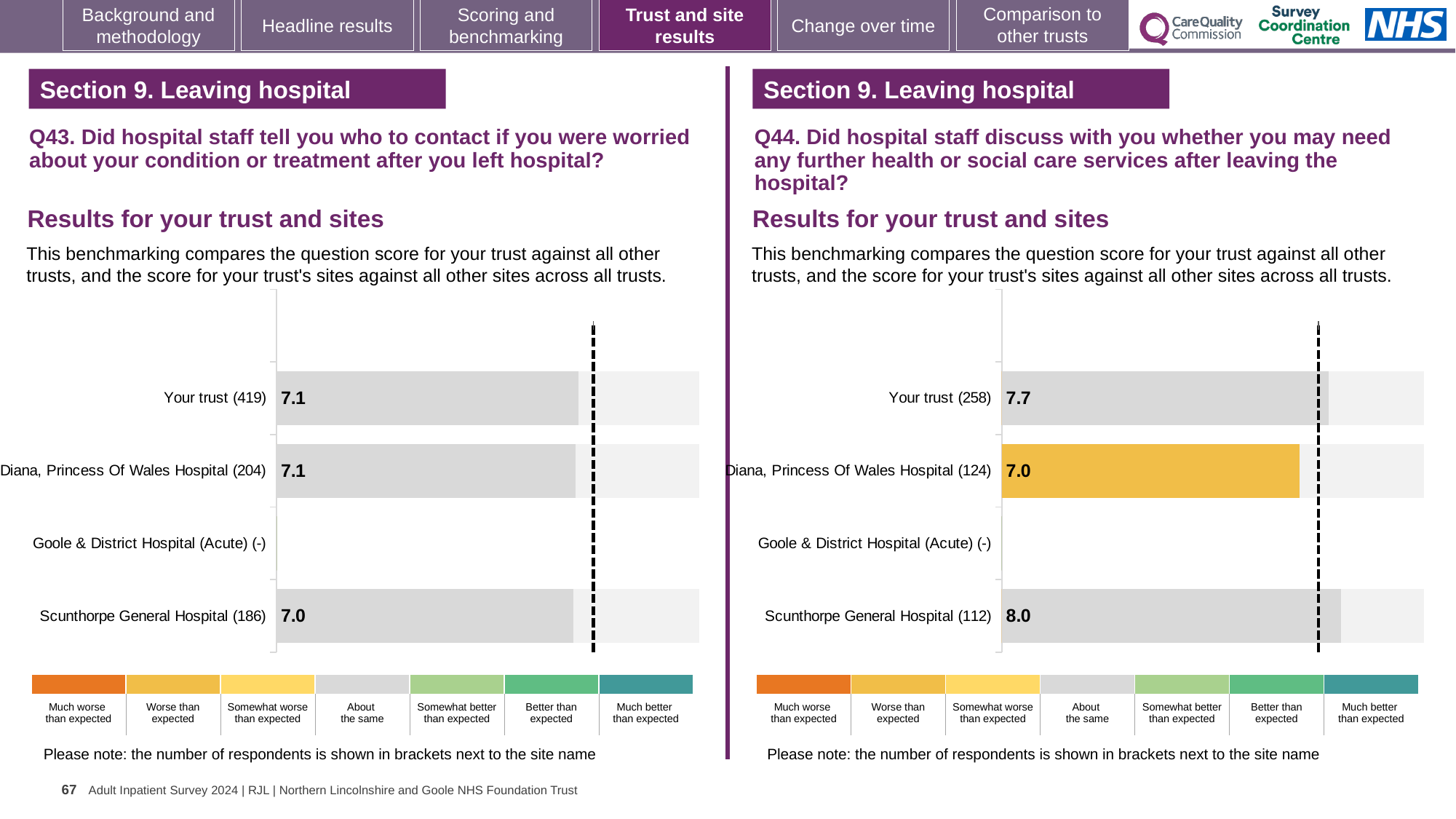
In the Q44 chart on the right, what is the score for Scunthorpe General Hospital? 8.0 In the Q44 chart on the right, which site has the highest score? Scunthorpe General Hospital In the Q43 chart on the left, what is the score for Your trust? 7.1 In the Q44 chart on the right, which site's bar is coloured orange-yellow (Worse than expected)? Diana, Princess Of Wales Hospital In the Q44 chart on the right, what is the difference between the scores for Scunthorpe General Hospital and Diana, Princess Of Wales Hospital? 1.0 In the Q44 chart on the right, what is the score for Diana, Princess Of Wales Hospital? 7.0 What type of chart is used in the Q43 chart on the left? Bar chart In the Q44 chart on the right, which site has the lowest score? Diana, Princess Of Wales Hospital How many respondents are shown in brackets for Your trust in the Q44 chart on the right? 258 In the Q43 chart on the left, what is the score for Scunthorpe General Hospital? 7.0 In the Q43 chart on the left, which is larger: the score for Your trust or the score for Scunthorpe General Hospital? Your trust In the Q44 chart on the right, what is the score for Your trust? 7.7